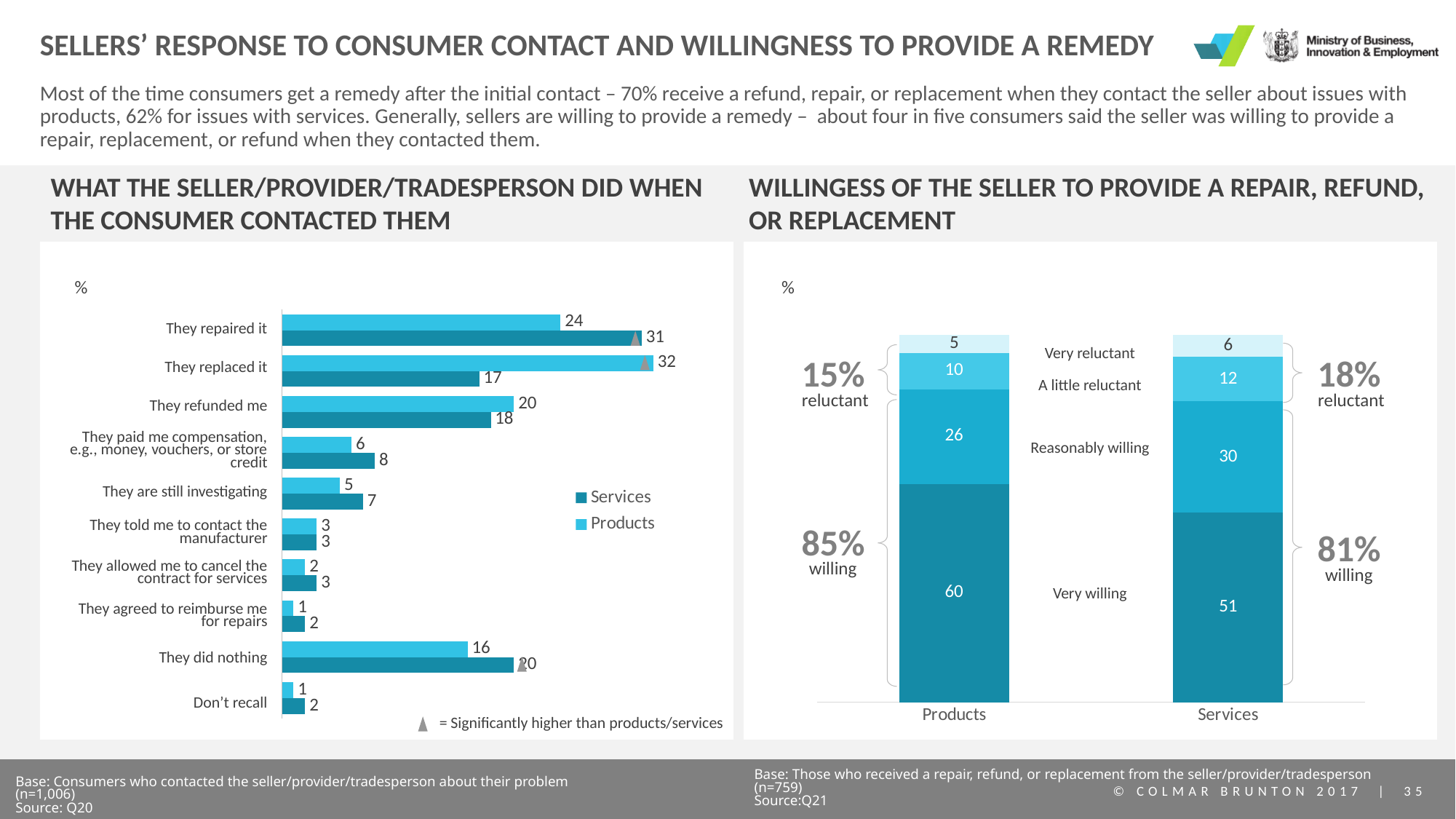
In the left chart, which category has the highest Products value? They replaced it In the right chart, what is the 'Reasonably willing' value for Products? 26 How many series does the legend of the left chart list? 2 What type of chart is the left chart? Bar chart In the left chart, what is the Products value for 'They replaced it'? 32 In the left chart, what is the difference between the Services and Products values for 'They repaired it'? 7 In the left chart, what percentage of consumers said the seller repaired it for services? 31 In the left chart, what is the Services value for 'They did nothing'? 20 How many categories are shown in the left chart? 10 In the right chart, what is the total percentage of consumers who were willing (reasonably or very) for Products? 85% In the left chart, which is larger for 'They refunded me': the Products value or the Services value? Products In the right chart, what is the 'Very willing' value for Services? 51